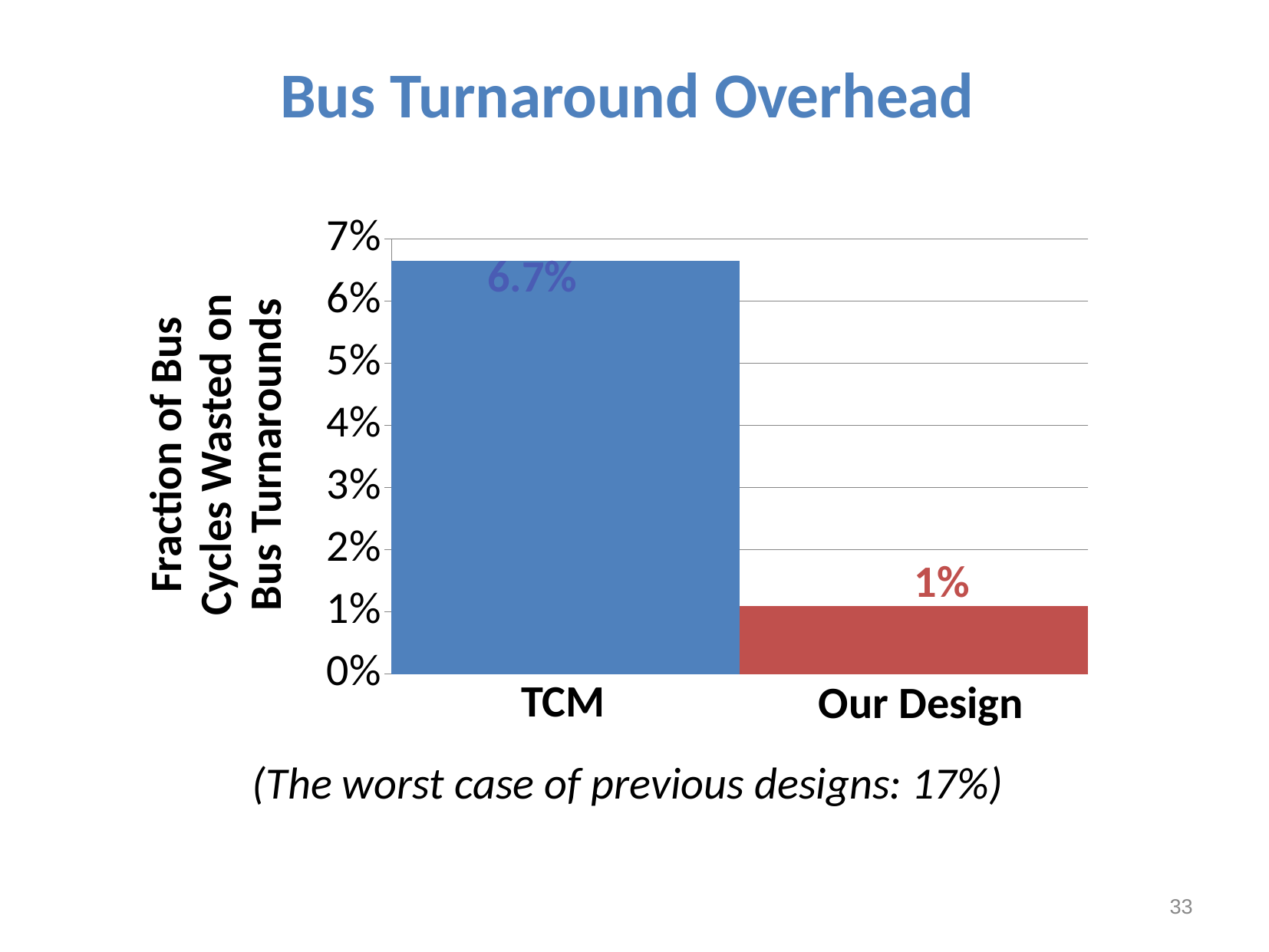
Which category has the highest fraction of bus cycles wasted on bus turnarounds? TCM Which is larger, the value for TCM or the value for Our Design? TCM What kind of chart is shown on the slide? bar chart What is the label of the y axis? Fraction of Bus Cycles Wasted on Bus Turnarounds Which category has the lowest fraction of bus cycles wasted on bus turnarounds? Our Design How many categories are shown on the x axis? 2 What is the value for TCM? 6.7% What is the difference between the values for TCM and Our Design? 5.7% Is the value for TCM greater or less than 5%? greater Is the value for Our Design greater or less than 2%? less What is the title of the chart? Bus Turnaround Overhead What is the value for Our Design? 1%